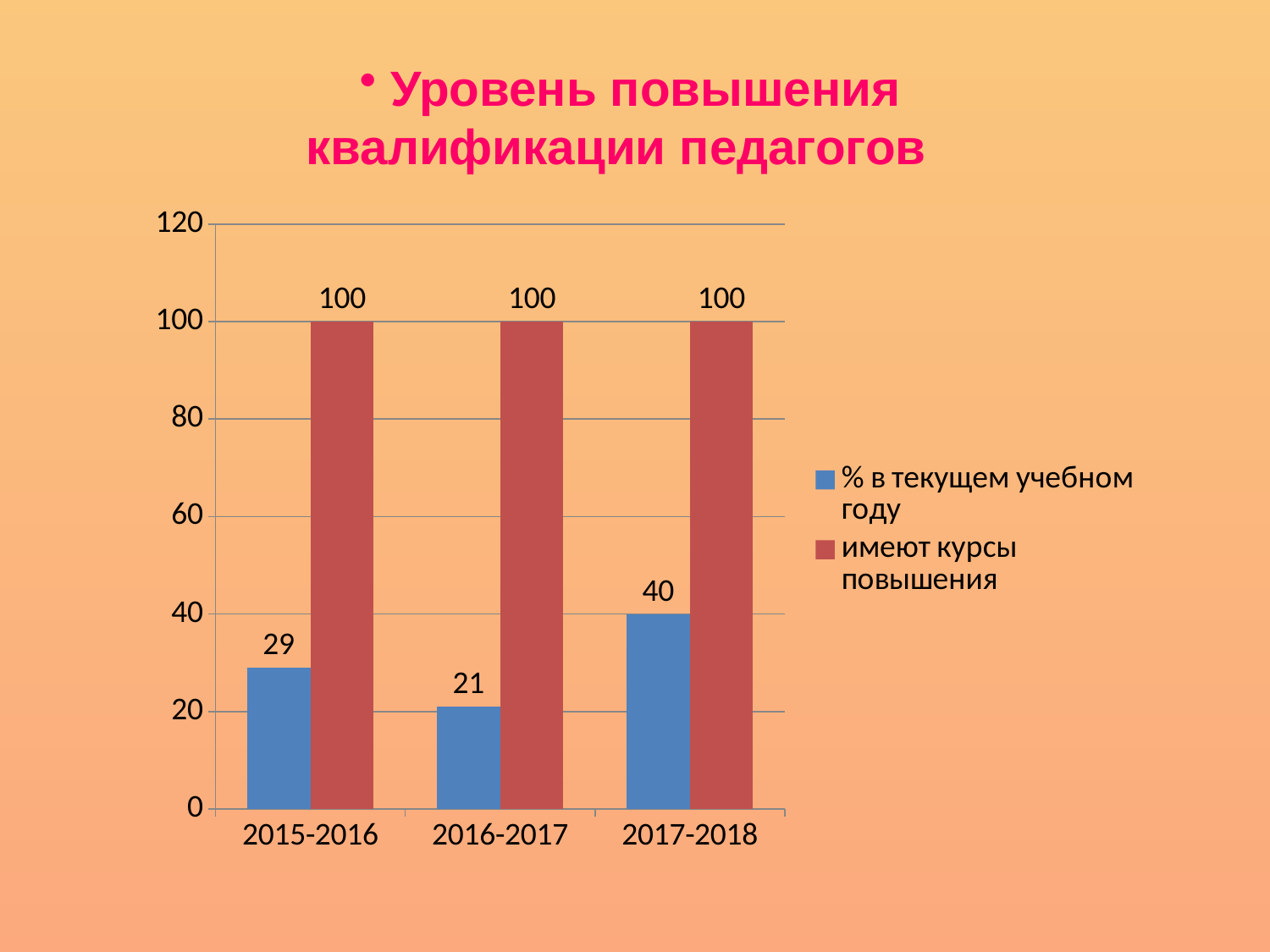
Which year has the lowest value for "% в текущем учебном году"? 2016-2017 How many year categories are shown on the x axis? 3 What is the difference between the "% в текущем учебном году" values for 2017-2018 and 2016-2017? 19 What colour are the bars for the series "имеют курсы повышения"? red Which year has the highest value for "% в текущем учебном году"? 2017-2018 Which is larger: the "% в текущем учебном году" value for 2015-2016 or for 2016-2017? 2015-2016 What kind of chart is shown on the slide? bar chart How many series does the legend list? 2 What is the value of "% в текущем учебном году" for 2015-2016? 29 What is the value of "имеют курсы повышения" for 2016-2017? 100 What is the value of "% в текущем учебном году" for 2017-2018? 40 What is the value of "% в текущем учебном году" for 2016-2017? 21